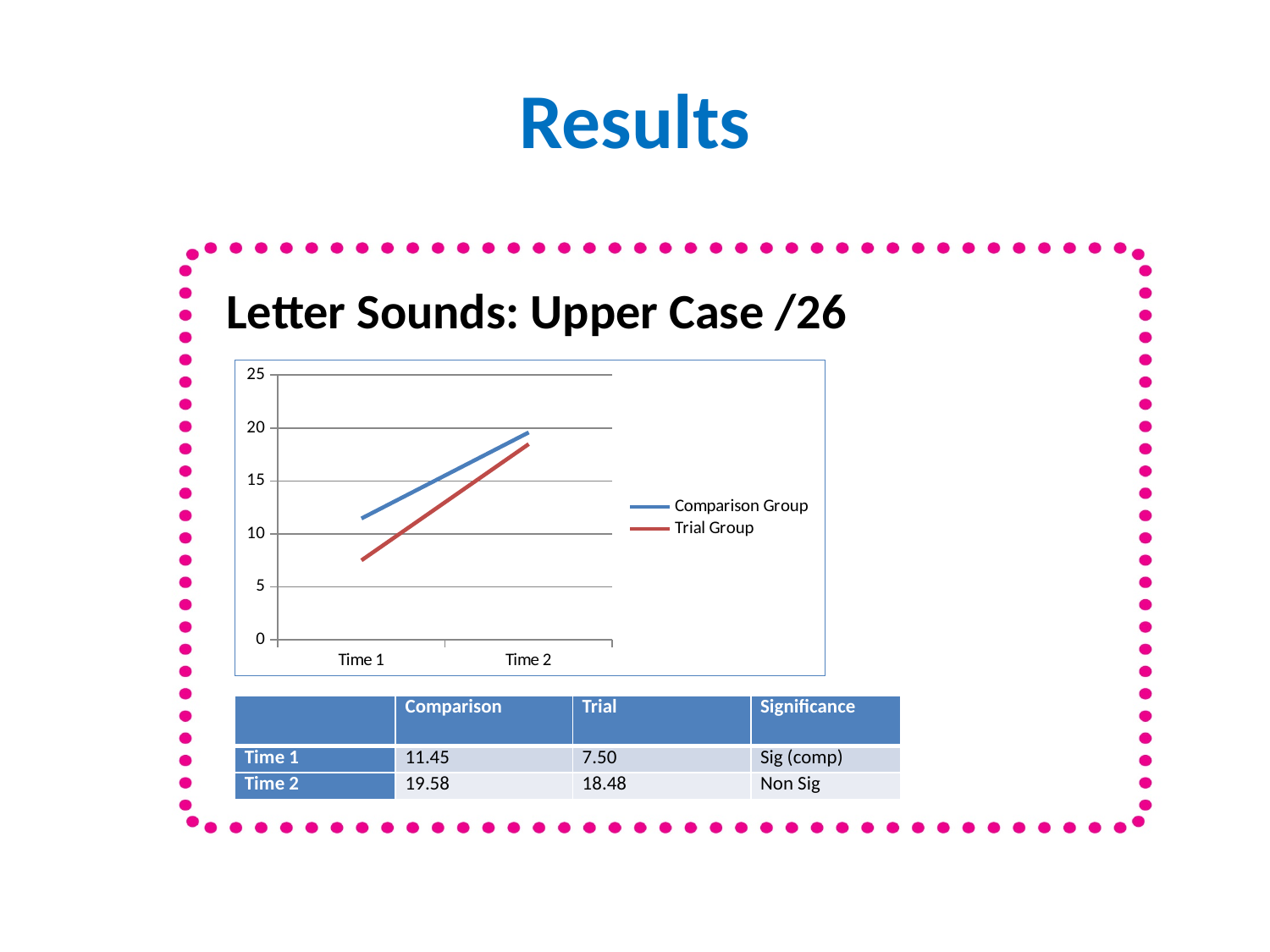
What is the Trial Group value at Time 2? 18.48 How many time points are plotted on the x axis of the chart? 2 Is the Comparison Group value at Time 2 greater or less than 15? greater What kind of chart is shown on the slide? line chart What is the Trial Group value at Time 1? 7.50 Do the values for the Trial Group rise or fall from Time 1 to Time 2? rise How many series does the chart legend list? 2 Which group has the higher value at Time 1? Comparison Group Is the Trial Group value at Time 1 greater or less than 10? less What is the difference between the Comparison Group and Trial Group values at Time 1? 3.95 What is the Comparison Group value at Time 1? 11.45 What is the title shown above the chart? Letter Sounds: Upper Case /26